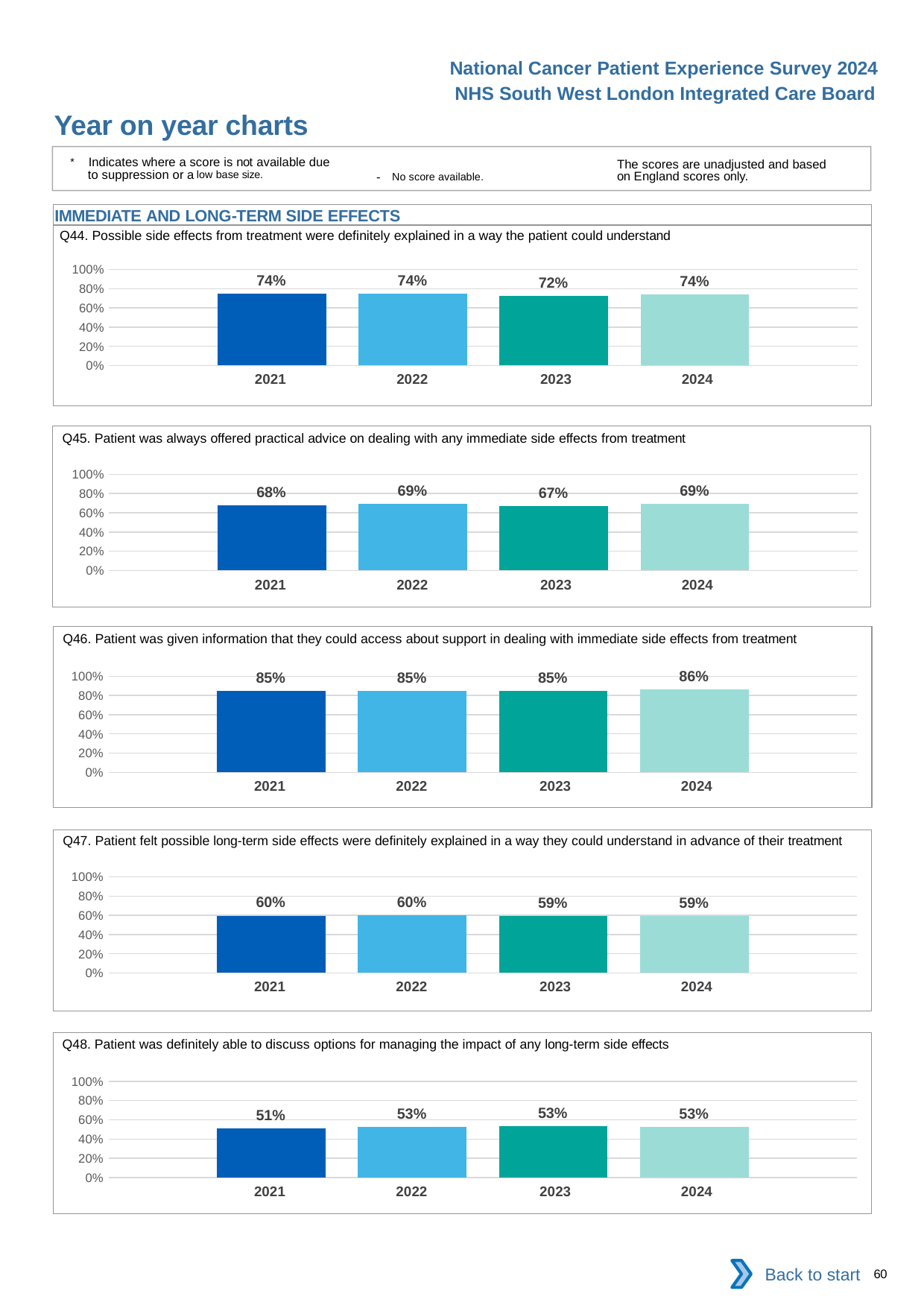
In the Q46 chart, what is the value for 2024? 86% In the Q48 chart, what is the value for 2021? 51% In the Q45 chart, what is the difference between the 2022 value and the 2023 value? 2% In the Q45 chart, which year has the lowest value? 2023 How many years are shown in the Q46 chart? 4 In the Q44 chart, what is the value for 2023? 72% In the Q47 chart, is the value for 2023 greater or less than 80%? less What kind of chart is the Q47 chart? bar chart In the Q48 chart, which year has the lowest value? 2021 How many charts are shown on the slide? 5 In the Q47 chart, what is the difference between the 2021 value and the 2024 value? 1% In the Q44 chart, is the value for 2022 larger or smaller than the value for 2023? larger